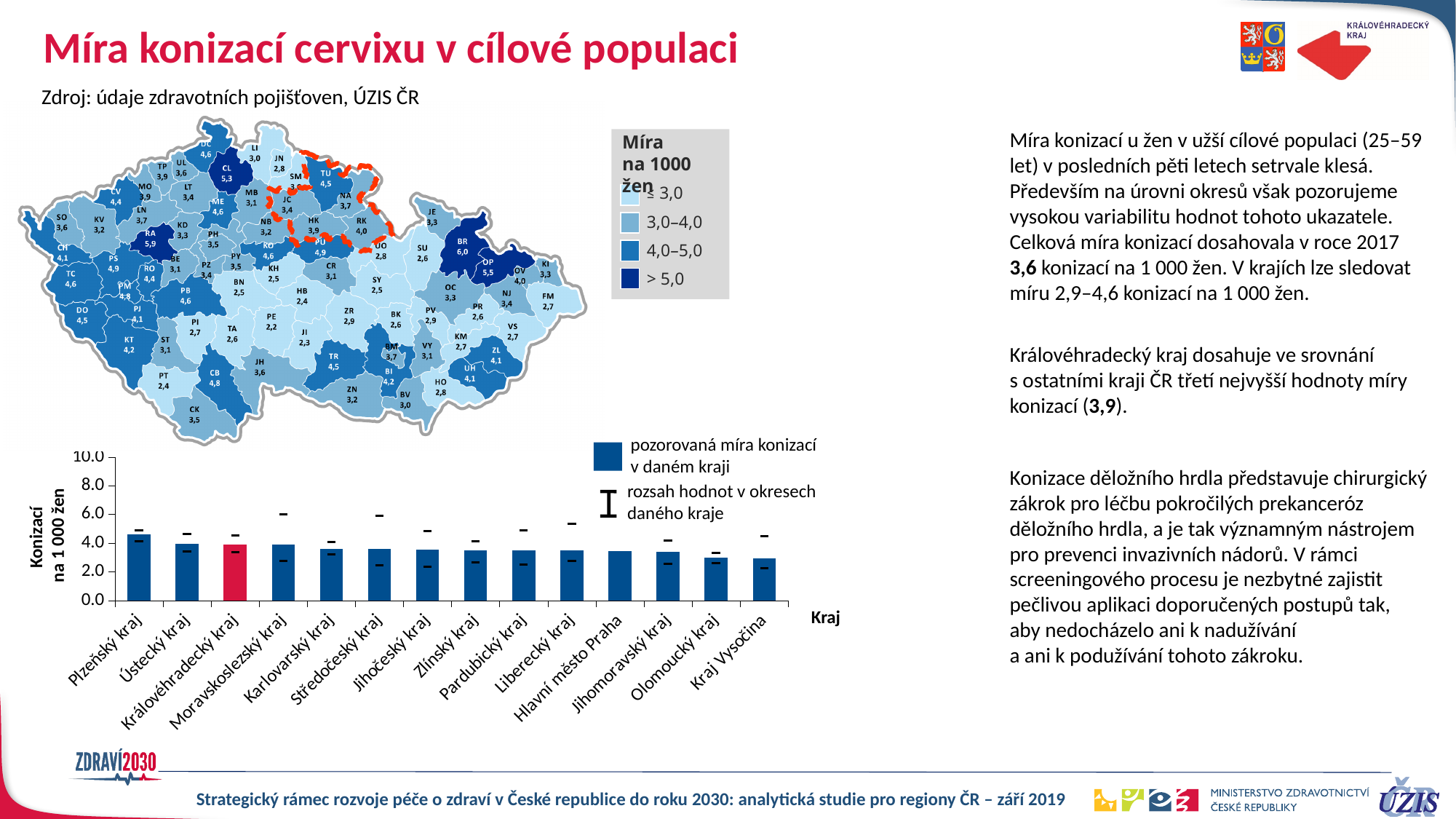
Is the value for Plzeňský kraj in the bar chart greater or less than 4.0? greater How many regions (kraje) are shown on the x axis of the bar chart? 14 Which region's bar is highlighted in red in the bar chart? Královéhradecký kraj In the bar chart, which region has the lowest observed conization rate? Kraj Vysočina What does the I-shaped marker in the bar chart legend represent? rozsah hodnot v okresech daného kraje In the bar chart, which is larger: the value for Plzeňský kraj or the value for Kraj Vysočina? Plzeňský kraj In the bar chart, which region has the highest observed conization rate? Plzeňský kraj Do the bar values in the bar chart rise or fall from left to right along the x axis? fall What kind of chart is shown at the bottom left of the slide? bar chart Is the value for Olomoucký kraj in the bar chart greater or less than 4.0? less Is the value for Kraj Vysočina in the bar chart greater or less than 4.0? less According to the slide, what is the conization rate for Královéhradecký kraj? 3,9